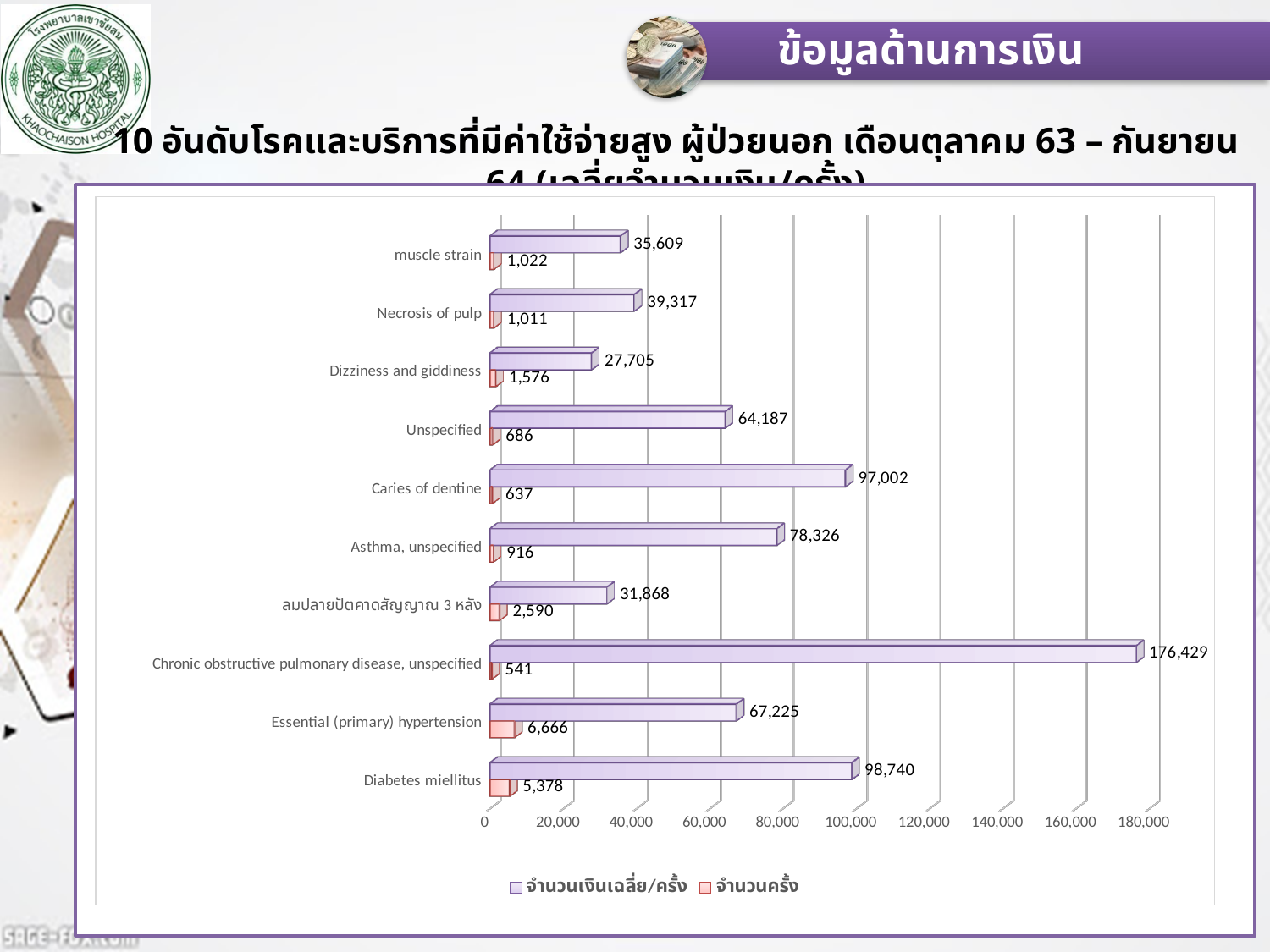
Is the จำนวนเงินเฉลี่ย/ครั้ง value for Essential (primary) hypertension greater or less than 60,000? greater What is the difference between the จำนวนเงินเฉลี่ย/ครั้ง values for Diabetes miellitus and Caries of dentine? 1,738 How many series does the legend list? 2 Which has a larger จำนวนเงินเฉลี่ย/ครั้ง value, Asthma, unspecified or Unspecified? Asthma, unspecified What is the จำนวนเงินเฉลี่ย/ครั้ง value for Caries of dentine? 97,002 Which category has the highest จำนวนเงินเฉลี่ย/ครั้ง value? Chronic obstructive pulmonary disease, unspecified What is the จำนวนครั้ง value for Essential (primary) hypertension? 6,666 Which category has the lowest จำนวนเงินเฉลี่ย/ครั้ง value? Dizziness and giddiness What is the จำนวนเงินเฉลี่ย/ครั้ง value for Chronic obstructive pulmonary disease, unspecified? 176,429 Which category has the lowest จำนวนครั้ง value? Chronic obstructive pulmonary disease, unspecified What kind of chart is shown on the slide? bar chart How many categories are shown on the chart? 10